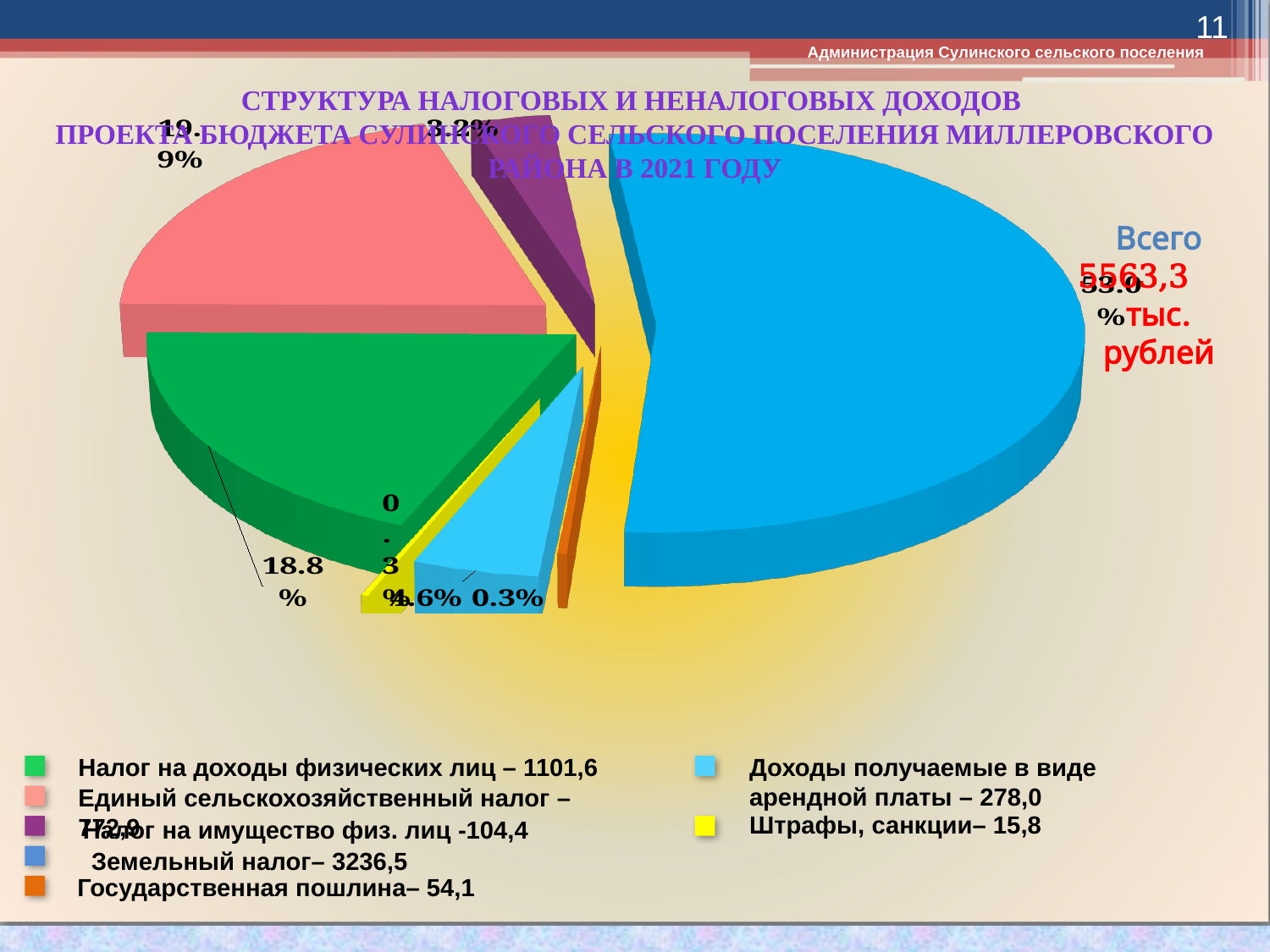
What is the total of all revenues shown on the slide? 5563,3 тыс. рублей Which category has the largest slice of the pie? Земельный налог What is the value for Земельный налог given in the legend? 3236,5 Which is larger: the share for Единый сельскохозяйственный налог or for Налог на доходы физических лиц? Единый сельскохозяйственный налог What share of the pie does Единый сельскохозяйственный налог have? 19.9% What share of the pie does Земельный налог have? 53.0% What share of the pie does Налог на имущество физ. лиц have? 3.2% What share of the pie does Налог на доходы физических лиц have? 18.8% What kind of chart is shown on the slide? pie chart What is the difference between the legend values for Земельный налог and Налог на доходы физических лиц? 2134,9 Which category has the smallest value according to the legend? Штрафы, санкции How many categories does the legend list? 7